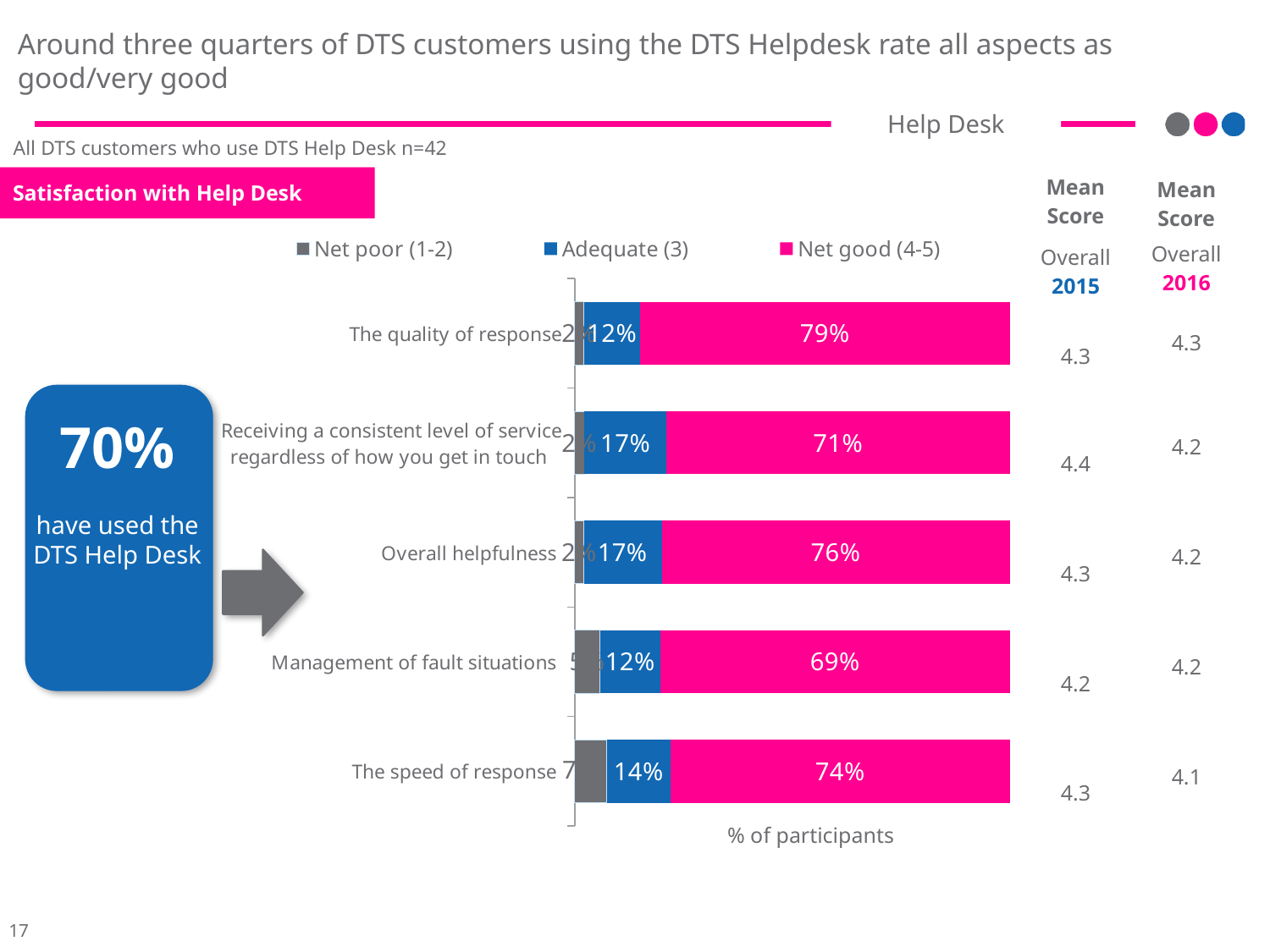
How many aspects of the Help Desk are shown in the chart? 5 Which aspect has the highest Net good (4-5) percentage? The quality of response Which aspect has the lowest Net good (4-5) percentage? Management of fault situations What is the label on the horizontal axis of the chart? % of participants What is the Adequate (3) value for 'Management of fault situations'? 12% What is the difference between the Adequate (3) value for 'Overall helpfulness' and for 'The quality of response'? 5 percentage points What is the difference in Net good (4-5) percentage between 'The quality of response' and 'Management of fault situations'? 10 percentage points How many series does the chart legend list? 3 What percentage of participants rated 'The speed of response' as Adequate (3)? 14% Which has a higher Net good (4-5) percentage: 'Overall helpfulness' or 'Receiving a consistent level of service regardless of how you get in touch'? Overall helpfulness What percentage of participants rated 'The quality of response' as Net good (4-5)? 79% What type of chart is used to show satisfaction with the Help Desk? Stacked bar chart